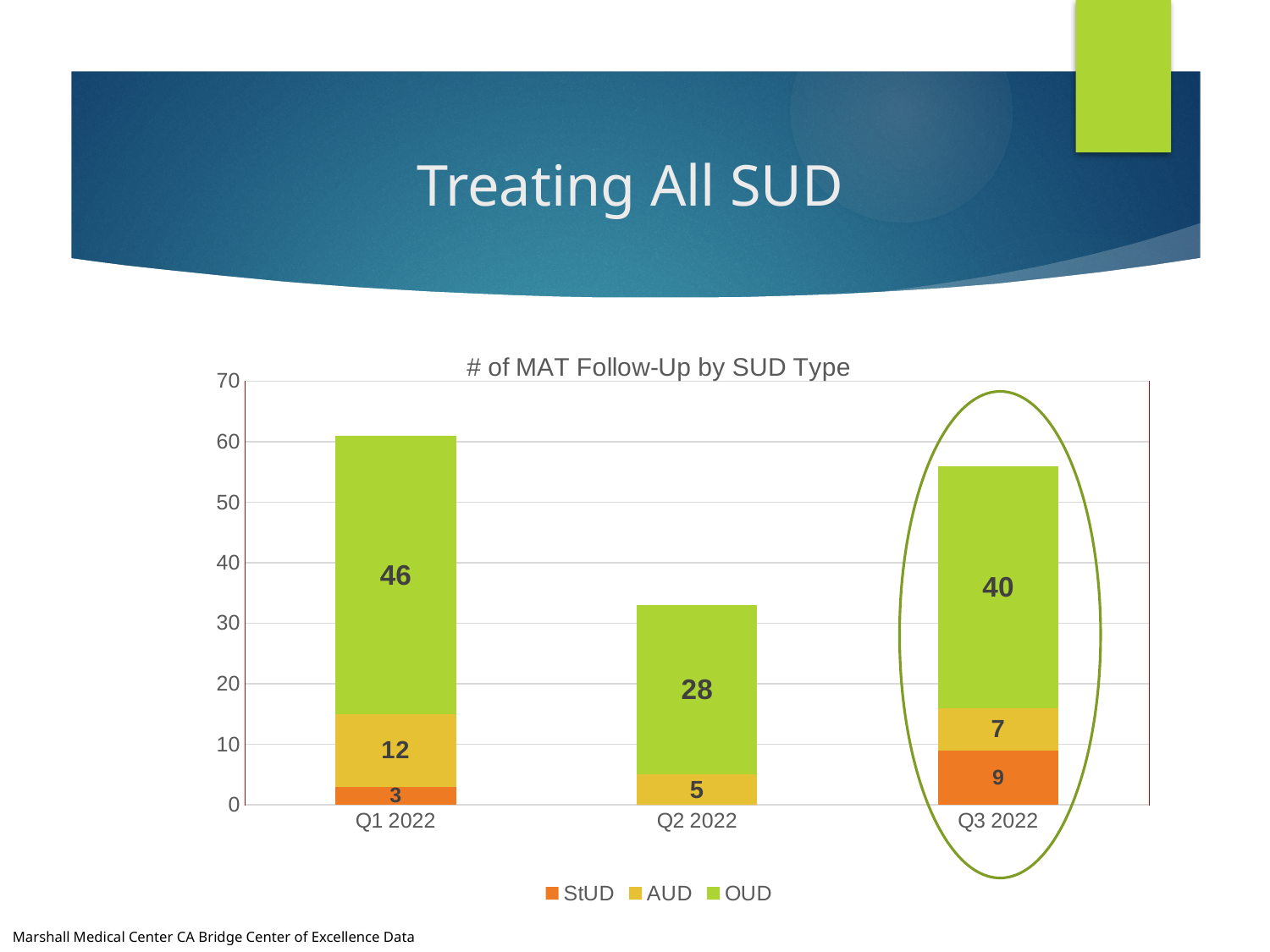
What is the AUD value for Q3 2022? 7 How many series does the legend list? 3 What is the OUD value for Q1 2022? 46 Which quarter has the highest AUD value? Q1 2022 What type of chart is shown on the slide? Stacked bar chart What is the total of the stacked bar for Q1 2022? 61 Is the total of the stacked bar for Q2 2022 greater or less than 40? less What is the difference between the OUD values for Q1 2022 and Q3 2022? 6 What is the StUD value for Q3 2022? 9 Which quarter has the lowest OUD value? Q2 2022 How many quarters are shown on the x axis? 3 What is the title of the chart? # of MAT Follow-Up by SUD Type